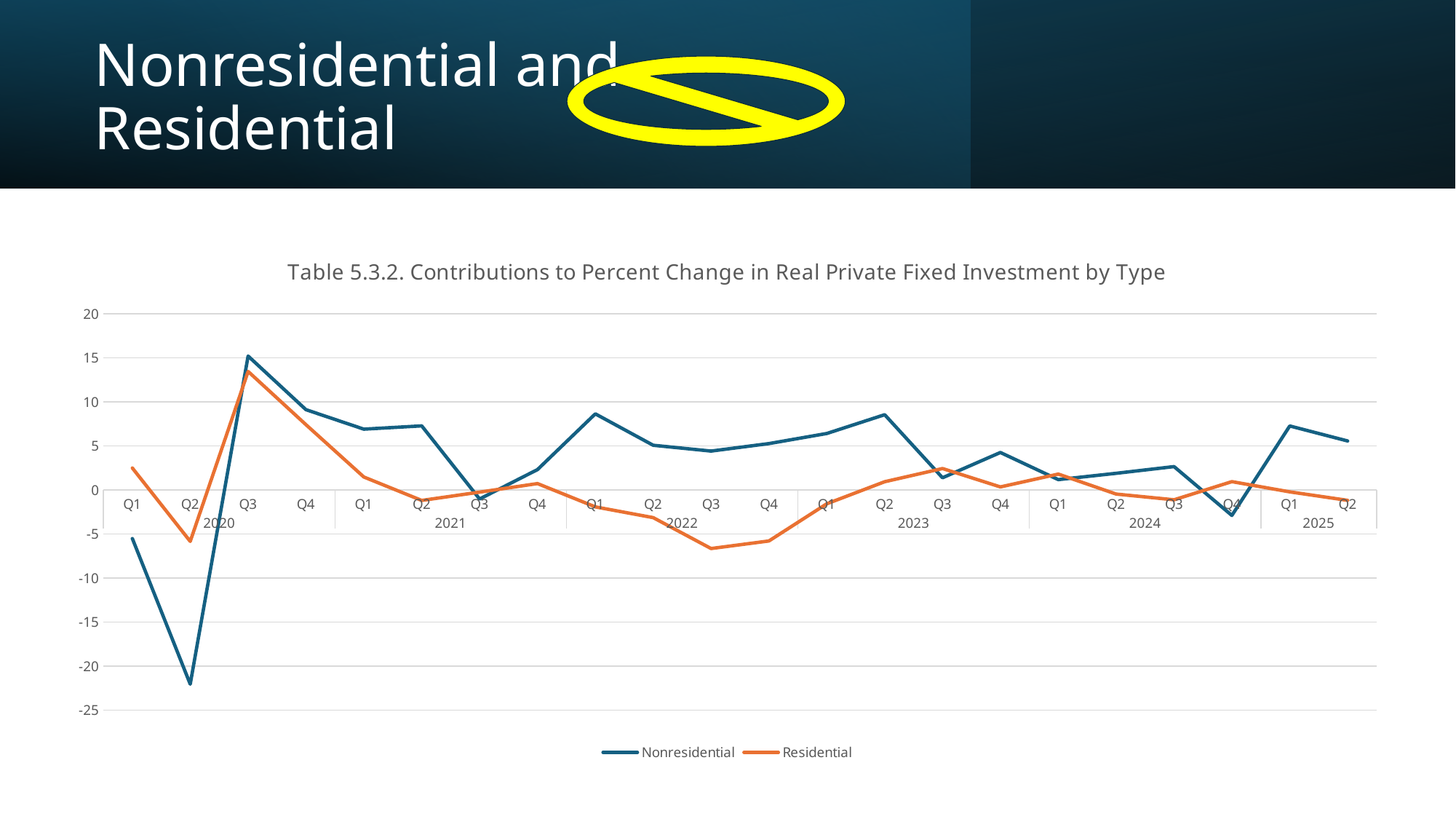
In Q2 2020, which series has the larger value, Nonresidential or Residential? Residential Is the Residential value for Q3 2022 greater or less than -5? less In which quarter does the Nonresidential series reach its lowest value? Q2 2020 Is the Residential value for Q3 2020 greater or less than 10? greater How many series does the legend list? 2 Does the Nonresidential series rise or fall from Q3 2020 to Q3 2021? Fall In which quarter does the Nonresidential series reach its highest value? Q3 2020 What kind of chart is shown on the slide? Line chart What is the title of the chart? Table 5.3.2. Contributions to Percent Change in Real Private Fixed Investment by Type Is the Nonresidential value for Q2 2020 greater or less than -20? less How many quarterly data points are plotted along the x axis? 22 In which quarter does the Residential series reach its highest value? Q3 2020